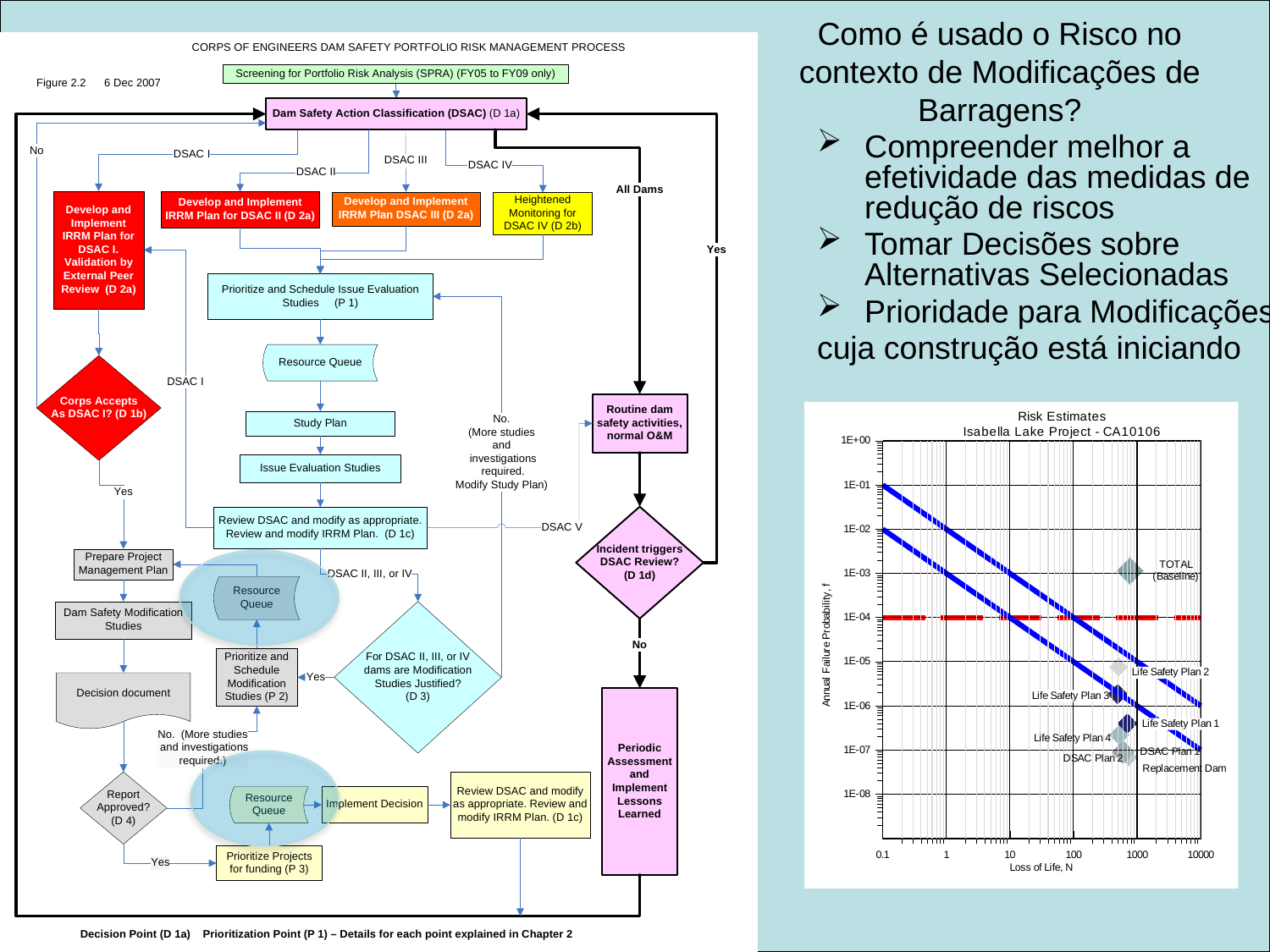
In the Risk Estimates chart, is the annual failure probability for Life Safety Plan 1 greater or less than 1E-05? less How many labeled data points are shown in the Risk Estimates chart? 8 In the Risk Estimates chart, what is the highest value shown on the x axis? 10000 In the Risk Estimates chart, is the annual failure probability for TOTAL (Baseline) greater or less than 1E-04? greater In the Risk Estimates chart, what is the label of the x axis? Loss of Life, N What is the title of the chart on the right side of the slide? Risk Estimates Isabella Lake Project - CA10106 In the Risk Estimates chart, is the annual failure probability for Life Safety Plan 2 greater or less than 1E-04? less What kind of chart is the Risk Estimates chart? scatter chart In the Risk Estimates chart, which labeled point has the highest annual failure probability? TOTAL (Baseline) In the Risk Estimates chart, which has the higher annual failure probability, TOTAL (Baseline) or Life Safety Plan 3? TOTAL (Baseline) In the Risk Estimates chart, which has the higher annual failure probability, Life Safety Plan 2 or Replacement Dam? Life Safety Plan 2